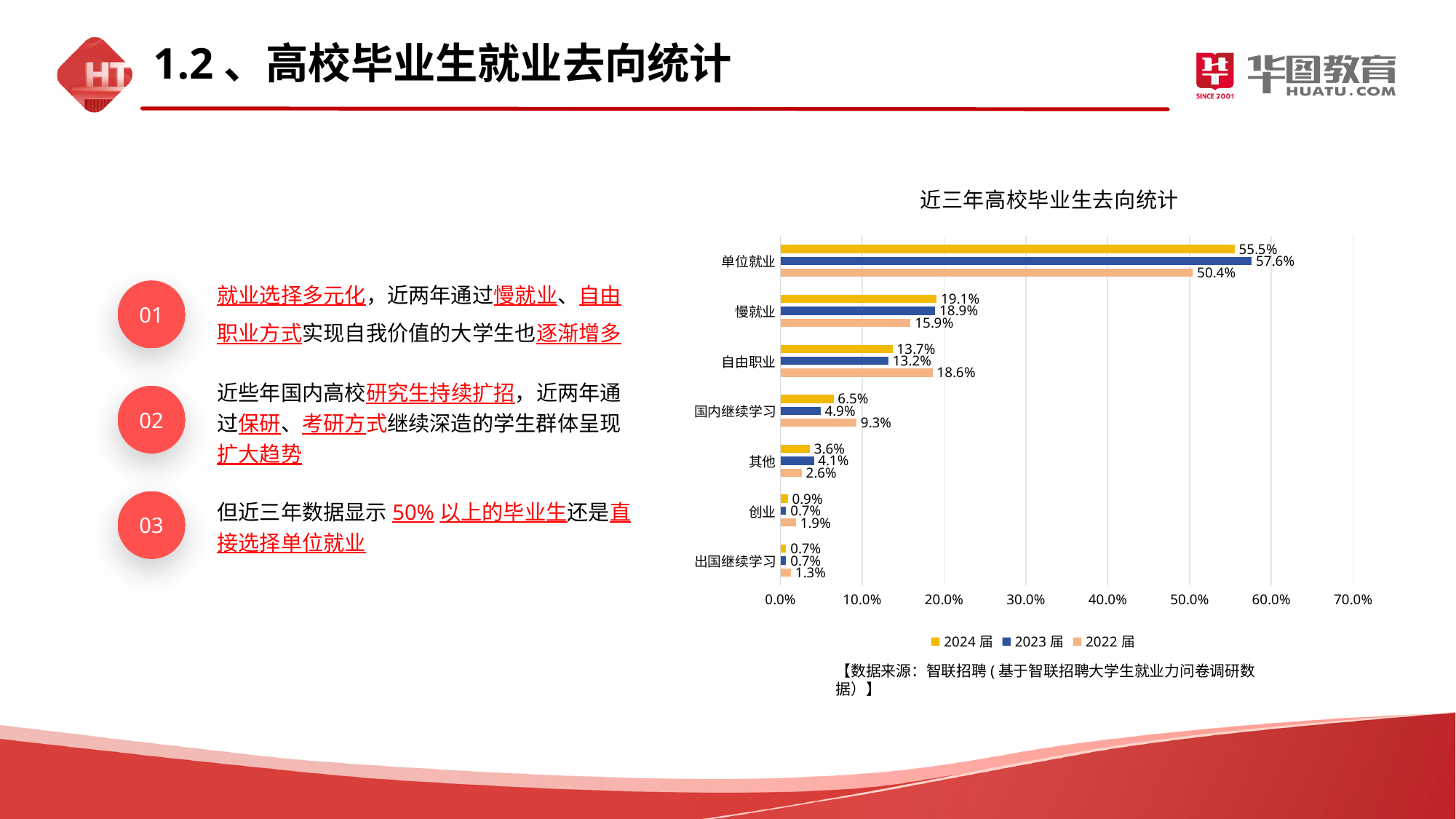
What is the value for 单位就业 in the 2023 届 series? 57.6% What is the value for 国内继续学习 in the 2024 届 series? 6.5% What type of chart is shown on the slide? bar chart What is the difference between the 2023 届 and 2022 届 values for 单位就业? 7.2% How many categories are shown on the y axis of the chart? 7 How many series does the legend list? 3 Which is larger for 自由职业: the 2024 届 value or the 2022 届 value? 2022 届 What is the difference between the 2024 届 and 2023 届 values for 慢就业? 0.2% What is the title of the chart? 近三年高校毕业生去向统计 Which category has the lowest value in the 2022 届 series? 出国继续学习 Which category has the highest value in the 2024 届 series? 单位就业 What is the value for 自由职业 in the 2022 届 series? 18.6%